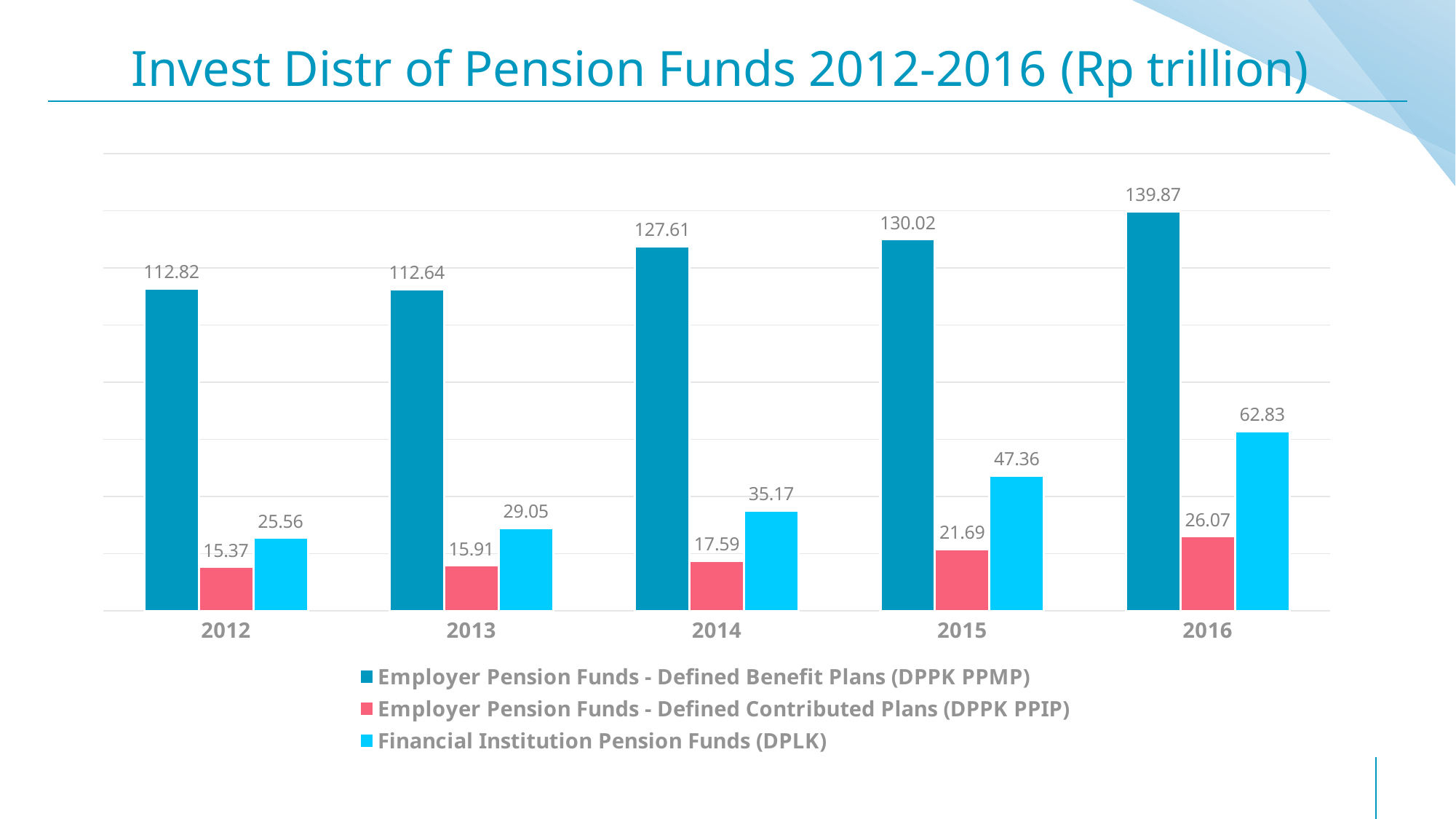
What is the difference between the Financial Institution Pension Funds (DPLK) values in 2016 and 2015? 15.47 In which year is the Employer Pension Funds - Defined Benefit Plans (DPPK PPMP) value lowest? 2013 What is the value for Financial Institution Pension Funds (DPLK) in 2014? 35.17 How many series does the legend list? 3 What is the title of the chart? Invest Distr of Pension Funds 2012-2016 (Rp trillion) What kind of chart is shown on the slide? Bar chart What is the value for Employer Pension Funds - Defined Contributed Plans (DPPK PPIP) in 2013? 15.91 How many years are shown on the x axis? 5 In which year is the Financial Institution Pension Funds (DPLK) value highest? 2016 What is the value for Employer Pension Funds - Defined Benefit Plans (DPPK PPMP) in 2016? 139.87 Do the Financial Institution Pension Funds (DPLK) values rise or fall from 2012 to 2016? Rise Which is larger in 2012: Employer Pension Funds - Defined Contributed Plans (DPPK PPIP) or Financial Institution Pension Funds (DPLK)? Financial Institution Pension Funds (DPLK)